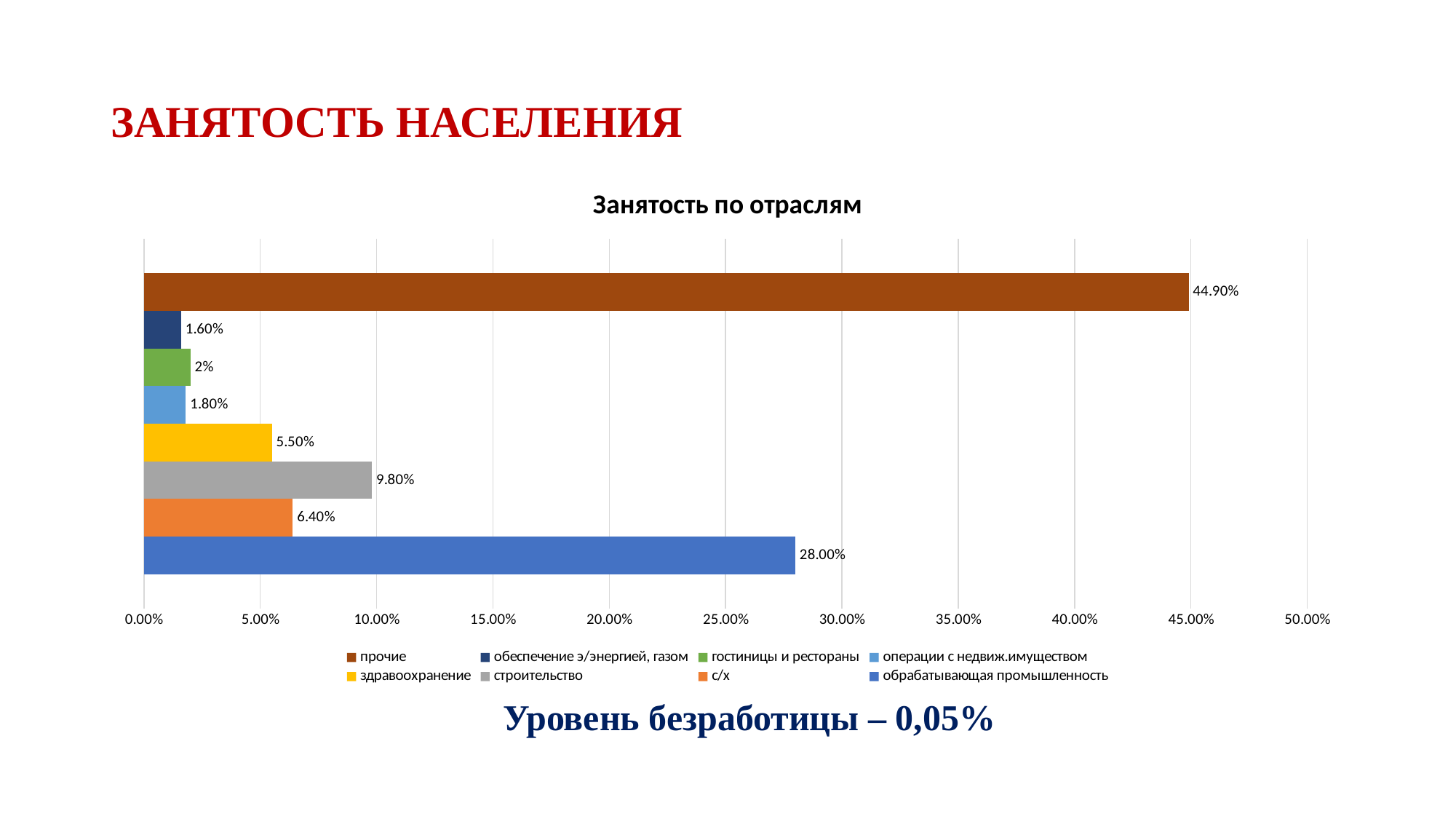
What is the difference between the values for прочие and обрабатывающая промышленность? 16.90% Which category has the lowest value? обеспечение э/энергией, газом Which category has the highest value? прочие What is the value for обрабатывающая промышленность? 28.00% Which is larger, the value for строительство or the value for с/х? строительство What is the title of the chart? Занятость по отраслям What is the value for строительство? 9.80% What is the value for прочие? 44.90% What type of chart is shown on the slide? bar chart What is the value for здравоохранение? 5.50% How many categories does the legend list? 8 Is the value for обрабатывающая промышленность greater or less than 25.00%? greater